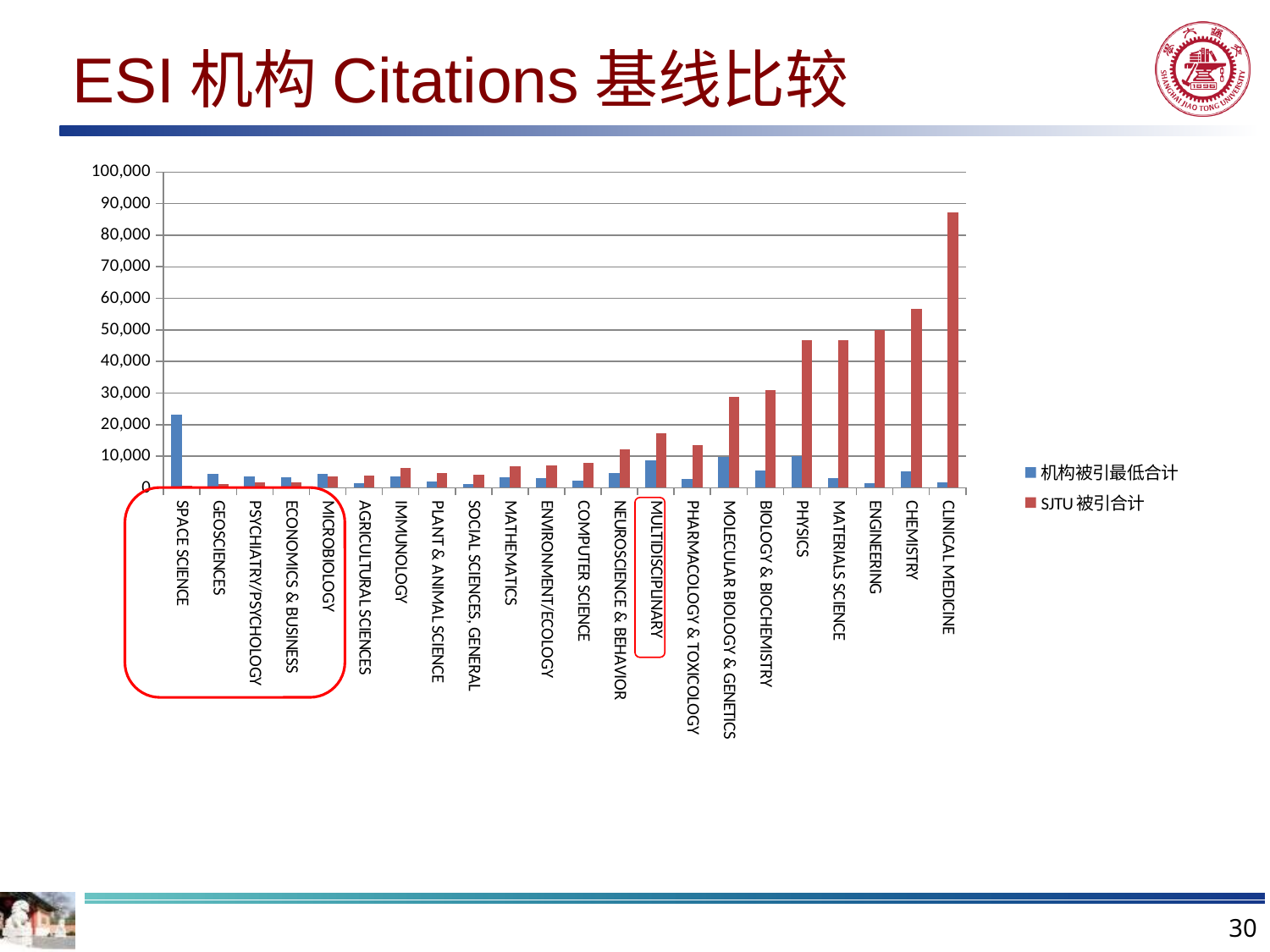
Is the SJTU 被引合计 value for PHYSICS greater or less than 50,000? less Which has the larger SJTU 被引合计 value, CHEMISTRY or MATERIALS SCIENCE? CHEMISTRY Is the SJTU 被引合计 value for CLINICAL MEDICINE greater or less than 80,000? greater Do the SJTU 被引合计 values generally rise or fall from left to right along the x axis? rise Which category has the highest 机构被引最低合计 value? SPACE SCIENCE How many categories are shown on the x axis? 22 Which colour represents the SJTU 被引合计 series? red For SPACE SCIENCE, which series has the larger value, 机构被引最低合计 or SJTU 被引合计? 机构被引最低合计 What kind of chart is shown on the slide? bar chart Which category has the highest SJTU 被引合计 value? CLINICAL MEDICINE Is the 机构被引最低合计 value for SPACE SCIENCE greater or less than 20,000? greater How many series does the legend list? 2